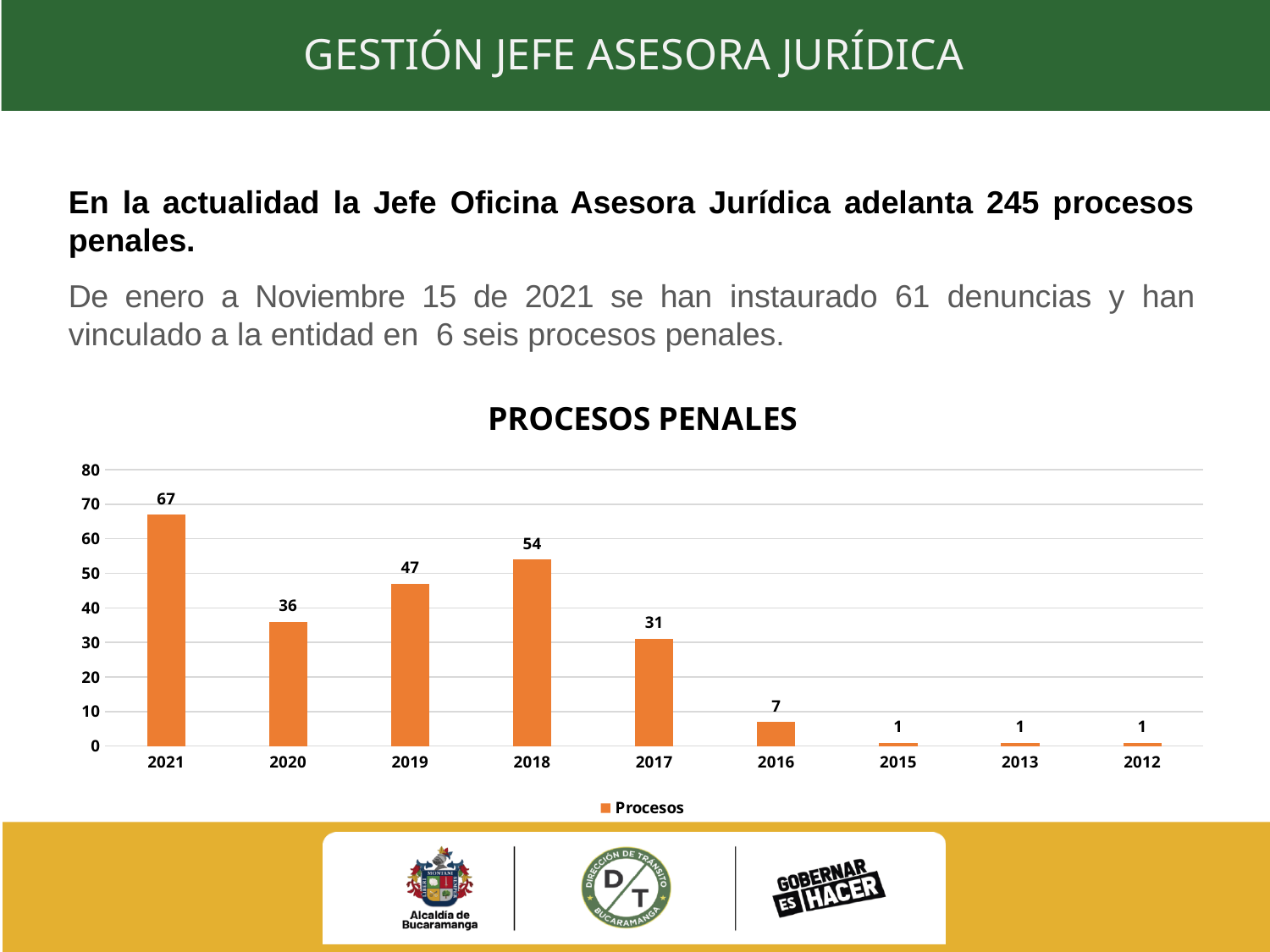
What is the value for 2021 in the PROCESOS PENALES chart? 67 How many series does the legend of the PROCESOS PENALES chart list? 1 How many years are shown on the x axis of the PROCESOS PENALES chart? 9 What kind of chart is the PROCESOS PENALES chart? bar chart What is the title of the chart on the slide? PROCESOS PENALES What is the difference between the values for 2018 and 2017 in the PROCESOS PENALES chart? 23 What is the value for 2018 in the PROCESOS PENALES chart? 54 Which is larger in the PROCESOS PENALES chart, the value for 2019 or the value for 2020? 2019 What is the value for 2016 in the PROCESOS PENALES chart? 7 Which year has the highest value in the PROCESOS PENALES chart? 2021 What is the difference between the values for 2021 and 2020 in the PROCESOS PENALES chart? 31 Is the value for 2017 in the PROCESOS PENALES chart greater or less than 40? less